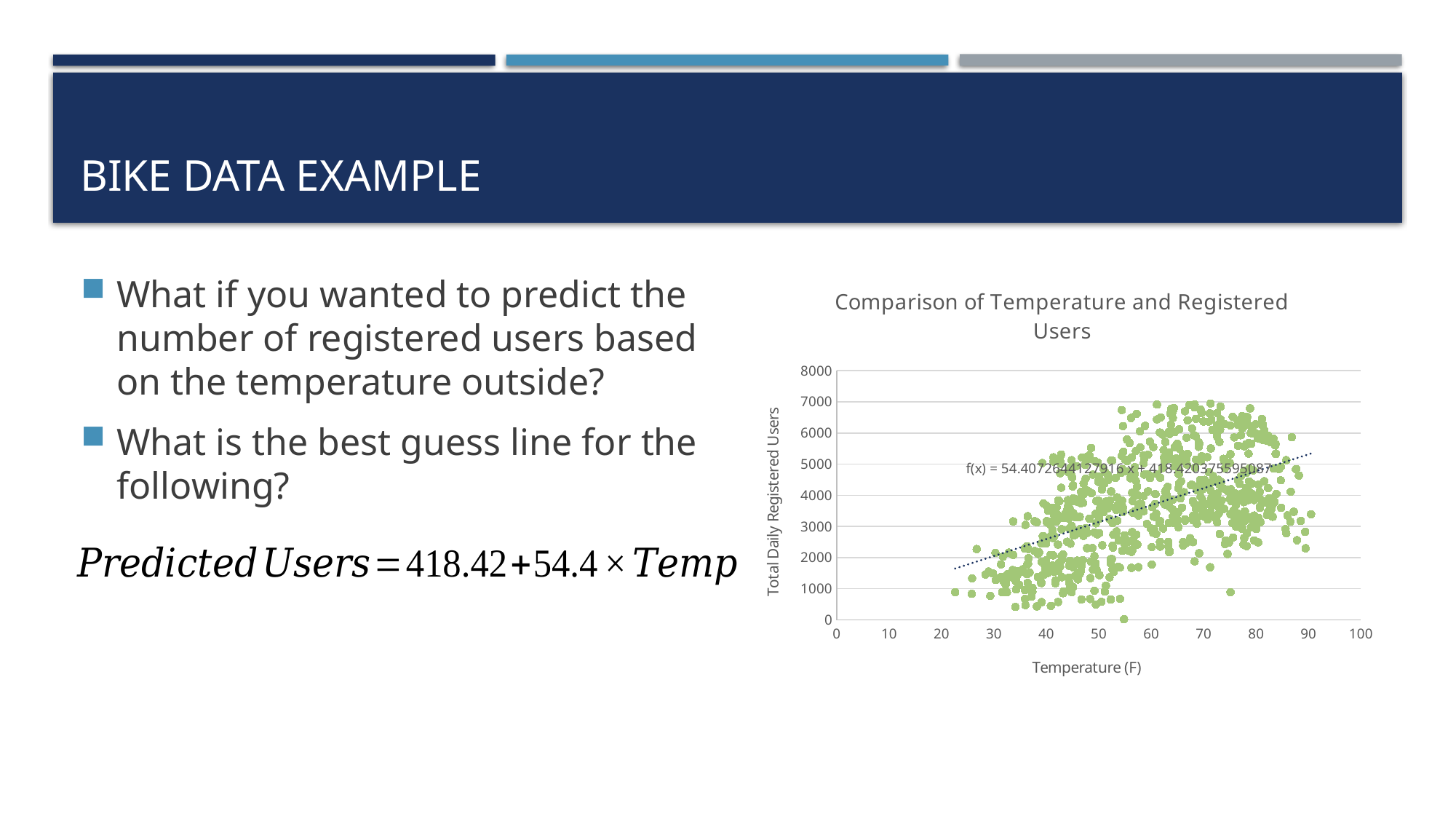
What is the slope of the trendline according to the equation printed on the chart? 54.4072644127916 Is the highest plotted registered-users value greater or less than 6000? greater Is the lowest plotted registered-users value greater or less than 1000? less What is the intercept of the trendline according to the equation printed on the chart? 418.420375595087 Is the lowest temperature plotted on the chart greater or less than 30? less What is the highest tick value shown on the horizontal axis of the chart? 100 What is the trendline equation printed on the chart? f(x) = 54.4072644127916 x + 418.420375595087 What kind of chart is shown on the slide? scatter chart Do the plotted registered-user values generally rise or fall as temperature increases along the x axis? rise What is the highest tick value shown on the vertical axis of the chart? 8000 What is the title of the chart? Comparison of Temperature and Registered Users